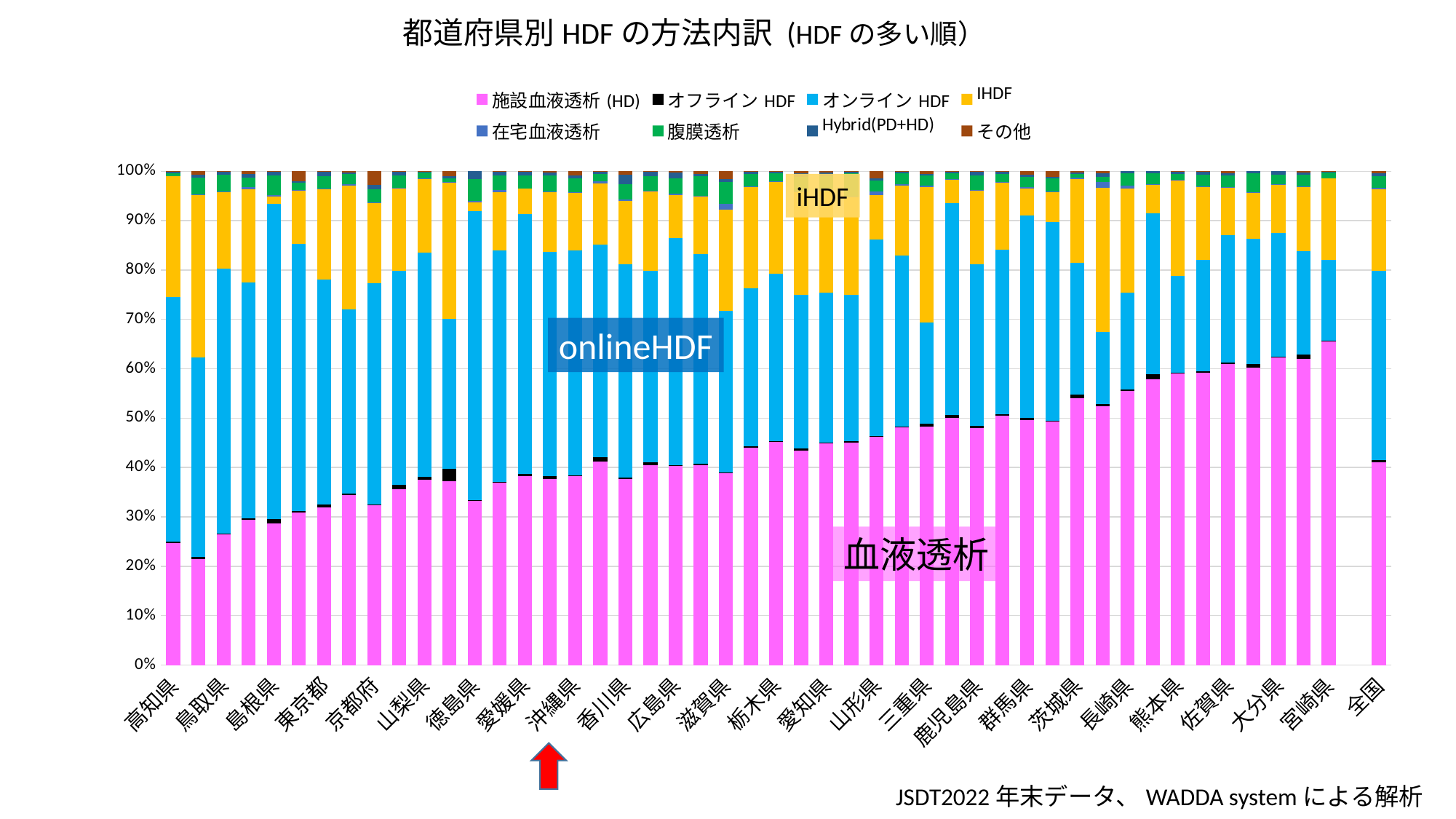
Which has the larger 施設血液透析 (HD) share, 高知県 or 全国? 全国 Which has the larger 施設血液透析 (HD) share, 鳥取県 or 宮崎県? 宮崎県 Is the 施設血液透析 (HD) share for 宮崎県 greater or less than 60%? greater What is the title of the chart? 都道府県別 HDF の方法内訳（HDF の多い順） Does the 施設血液透析 (HD) share generally rise or fall from left to right across the prefectures? rise Is the 施設血液透析 (HD) share for 熊本県 greater or less than 50%? greater Is the 施設血液透析 (HD) share for 高知県 greater or less than 30%? less How many series does the legend list? 8 Which series is shown in pink (magenta) in the chart? 施設血液透析 (HD) What kind of chart is shown on the slide? stacked bar chart